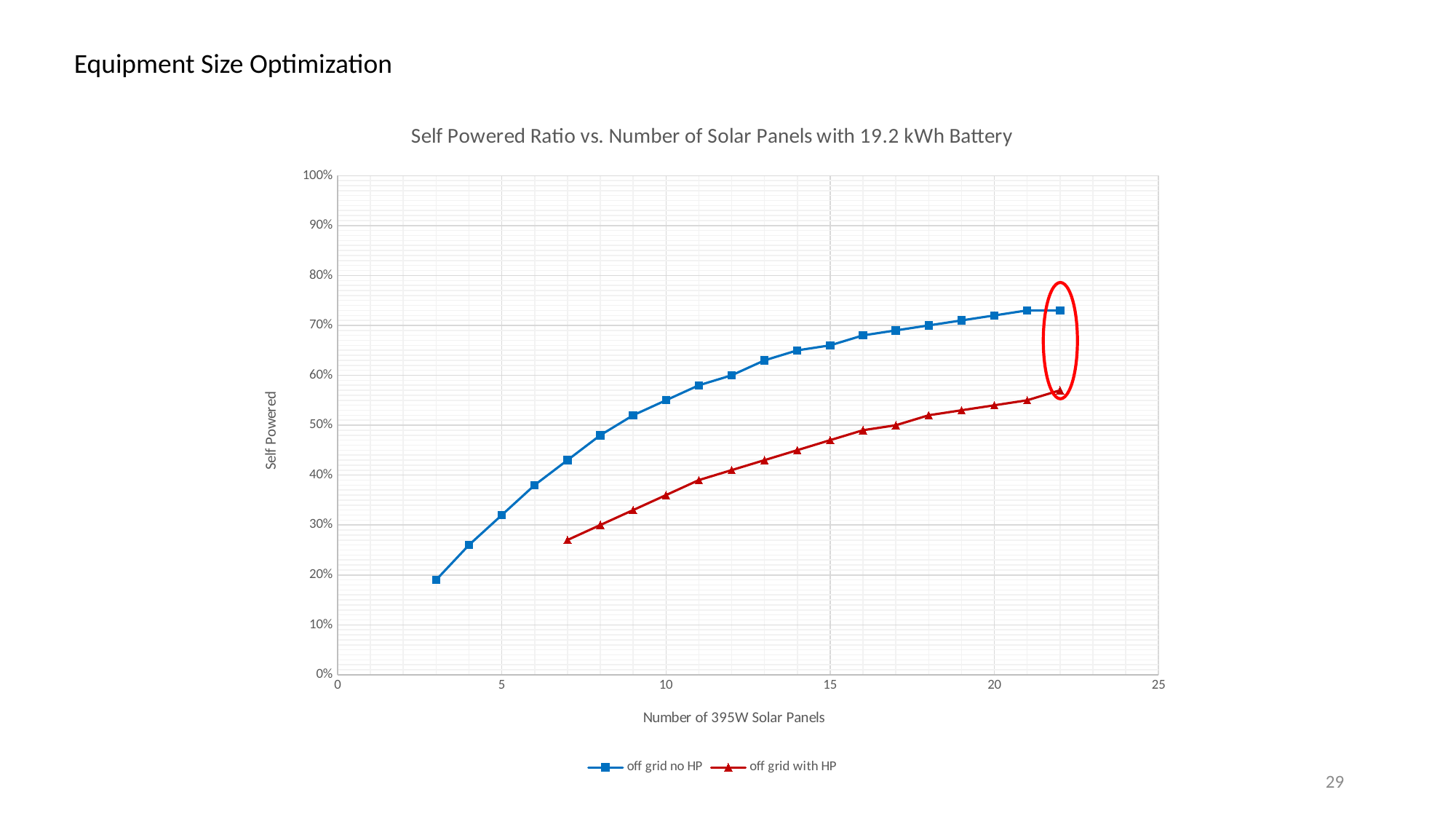
Is the 'off grid with HP' value at 15 solar panels greater or less than 50%? less Is the 'off grid with HP' value at 10 solar panels greater or less than 40%? less What is the title of the chart? Self Powered Ratio vs. Number of Solar Panels with 19.2 kWh Battery How many data points are plotted for the 'off grid with HP' series? 16 How many series does the legend list? 2 What kind of chart is shown on the slide? line chart Does the self powered ratio for 'off grid no HP' rise or fall as the number of solar panels increases? rise What is the label of the x axis? Number of 395W Solar Panels Does the self powered ratio for 'off grid with HP' rise or fall as the number of solar panels increases? rise Is the 'off grid no HP' value at 10 solar panels greater or less than 50%? greater At 15 solar panels, which series has the higher self powered ratio, 'off grid no HP' or 'off grid with HP'? off grid no HP